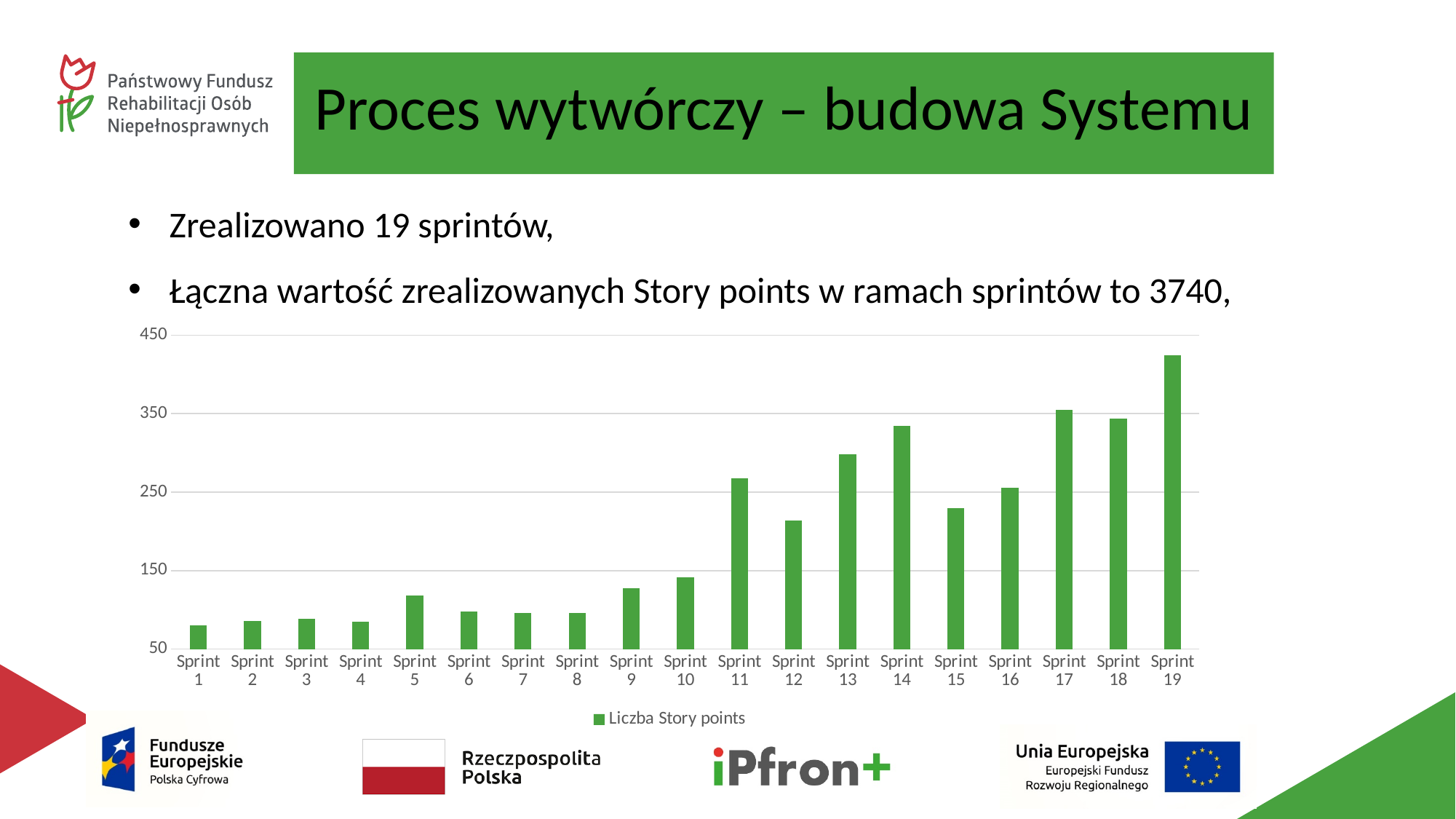
How many sprints are shown on the x axis of the chart? 19 How many series does the chart legend list? 1 Is the value for Sprint 12 greater or less than 250? less Which has more story points, Sprint 13 or Sprint 12? Sprint 13 Is the value for Sprint 10 greater or less than 150? less Is the value for Sprint 11 greater or less than 250? greater Do the story point values generally rise or fall from Sprint 1 to Sprint 19? rise What kind of chart is shown on the slide? bar chart Which has more story points, Sprint 17 or Sprint 15? Sprint 17 What is the name of the series in the chart legend? Liczba Story points Which sprint has the highest number of story points? Sprint 19